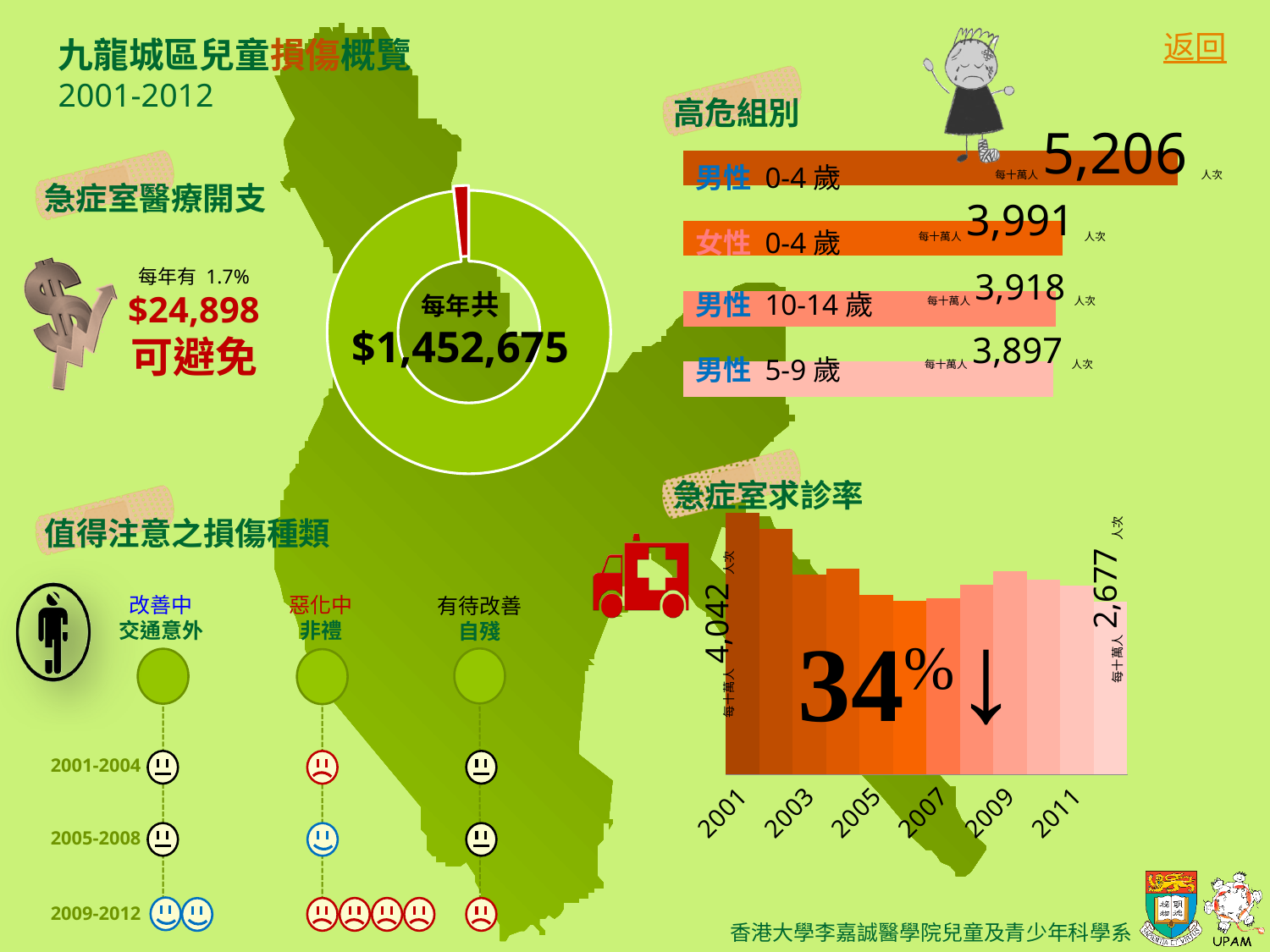
In the 高危組別 bar chart, what is the value for 男性 0-4 歲? 5,206 In the 高危組別 bar chart, what is the value for 男性 5-9 歲? 3,897 In the 急症室求診率 chart, do the values generally rise or fall from 2001 to 2012? fall In the 高危組別 bar chart, which group has the highest value? 男性 0-4 歲 In the 急症室醫療開支 donut chart, what is the total annual amount (每年共)? $1,452,675 In the 急症室求診率 chart, what is the value for the last year shown (2012)? 2,677 What kind of chart is the 急症室求診率 chart? bar chart In the 高危組別 bar chart, what is the difference between 男性 0-4 歲 and 女性 0-4 歲? 1,215 How many groups are shown in the 高危組別 bar chart? 4 In the 高危組別 bar chart, which group has the lowest value? 男性 5-9 歲 In the 高危組別 bar chart, what is the value for 女性 0-4 歲? 3,991 In the 急症室求診率 chart, what is the value for 2001? 4,042